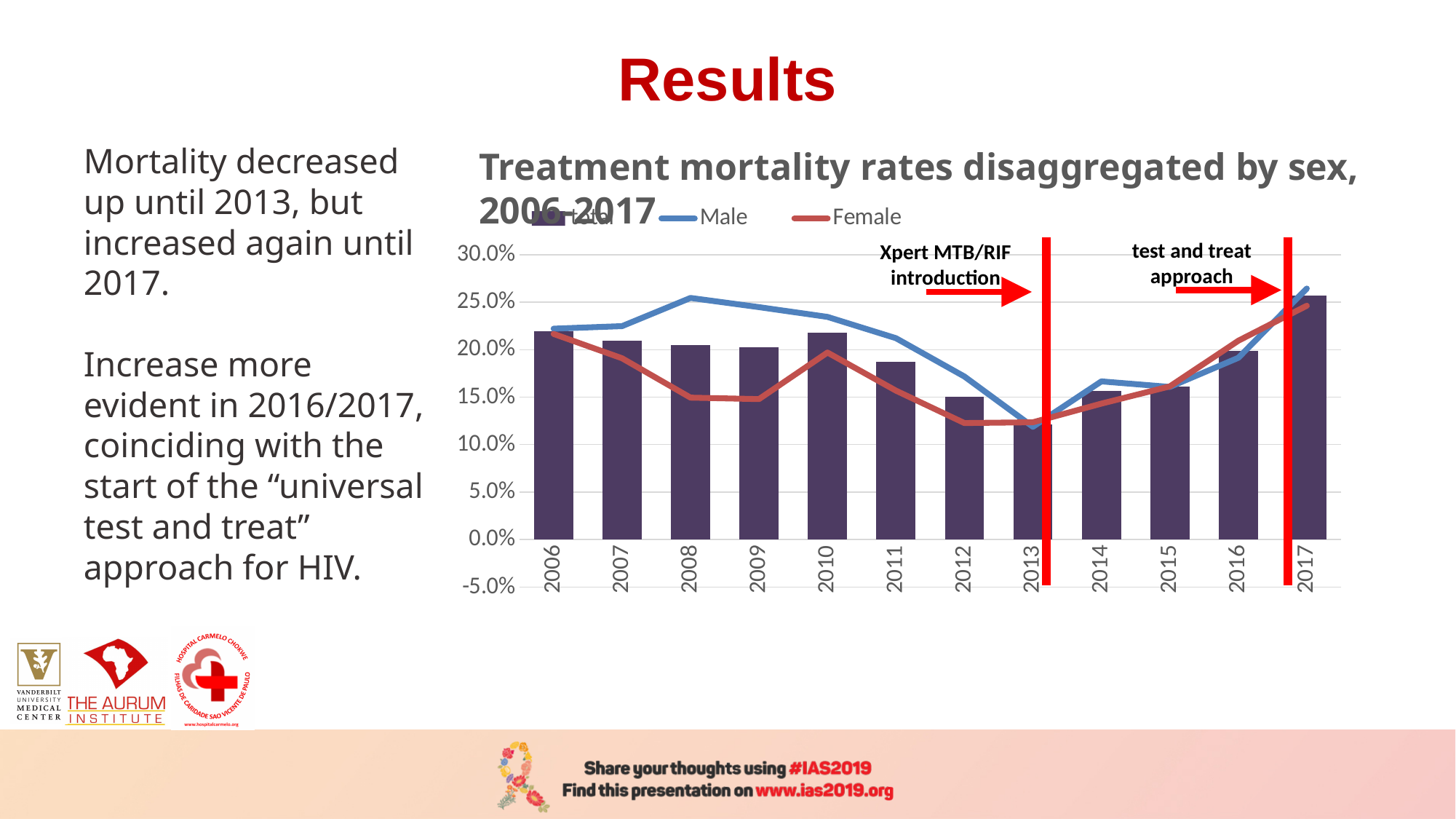
What kind of chart is shown on the slide? A combined bar and line chart How many years are shown on the x axis of the chart? 12 Is the Female value for 2012 greater or less than 15.0%? less How many series does the chart legend list? 3 Is the Male value for 2008 greater or less than 20.0%? greater Is the Total bar for 2006 greater or less than 20.0%? greater Which year has the lowest Total mortality bar? 2013 In 2008, which is higher, the Male or the Female mortality rate? Male Which year has the highest Total mortality bar? 2017 Do the Total mortality bars rise or fall from 2006 to 2013? Fall What is the title of the chart? Treatment mortality rates disaggregated by sex, 2006-2017